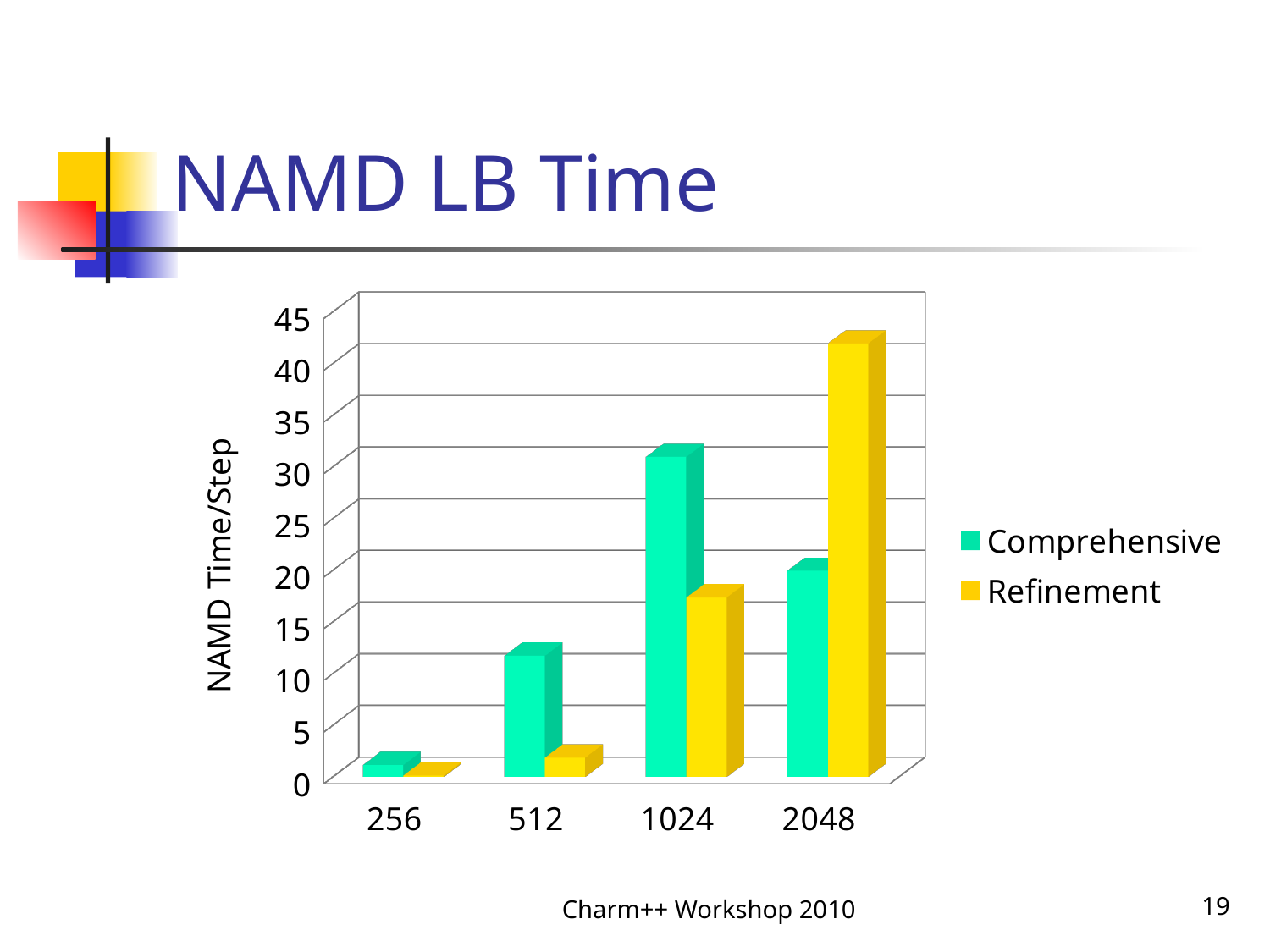
How many series does the legend list? 2 Is the Comprehensive value for 512 greater or less than 15? less Is the Comprehensive value for 1024 greater or less than 25? greater What is the label of the y axis? NAMD Time/Step What kind of chart is shown on the slide? bar chart Is the Refinement value for 2048 greater or less than 40? greater At 1024, which series has the larger value, Comprehensive or Refinement? Comprehensive Which category has the highest Comprehensive value? 1024 At 2048, which series has the larger value, Comprehensive or Refinement? Refinement Which category has the highest Refinement value? 2048 How many categories are shown on the x axis? 4 Which category has the lowest Comprehensive value? 256